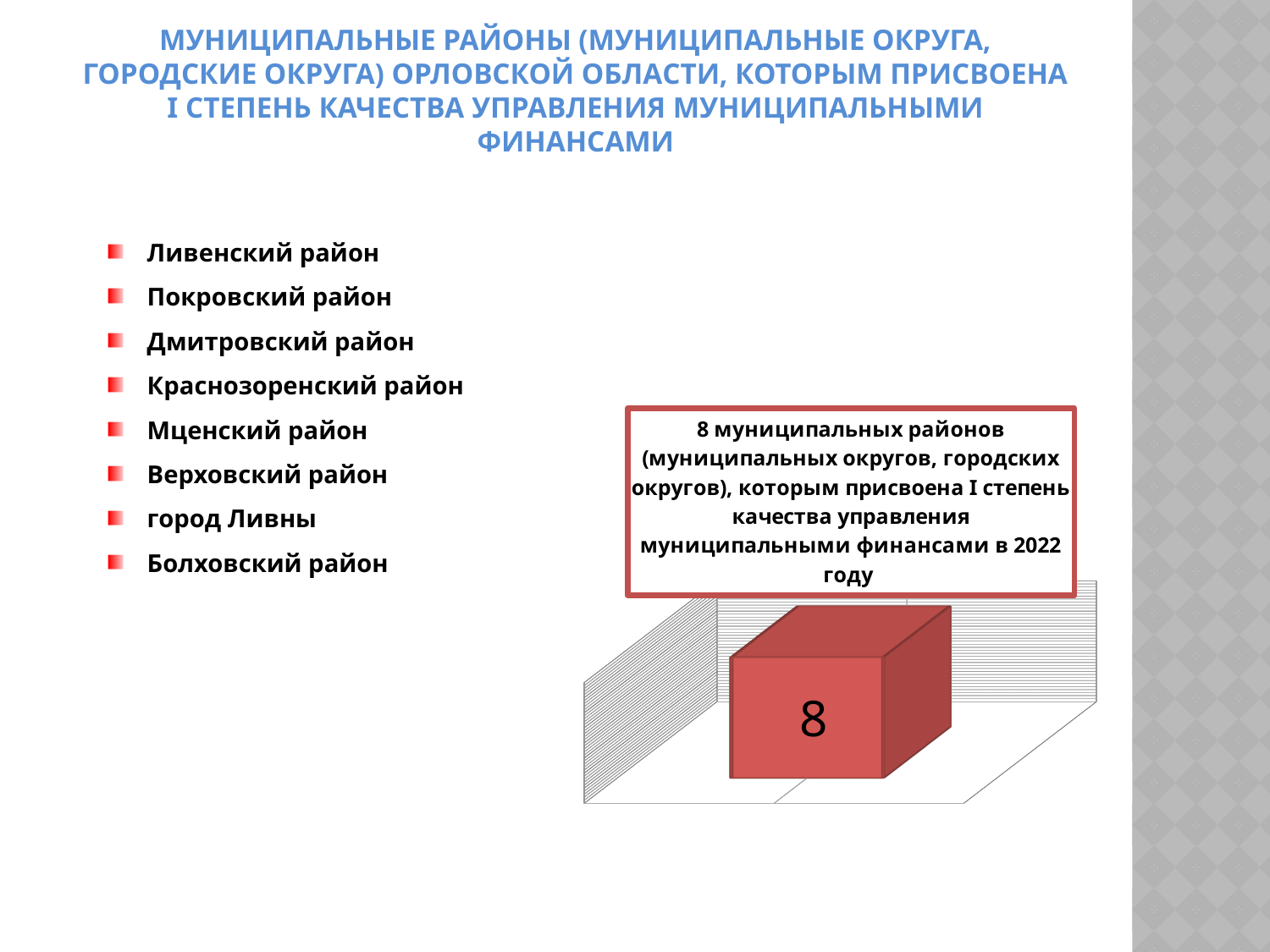
How many bars does the chart show? 1 What colour is the bar in the chart? red What value is printed on the single bar in the chart? 8 According to the chart's title, for which year is the number of municipal districts with I degree of financial management quality shown? 2022 What kind of chart is shown on the slide? bar chart Is the value shown on the bar greater or less than 5? greater